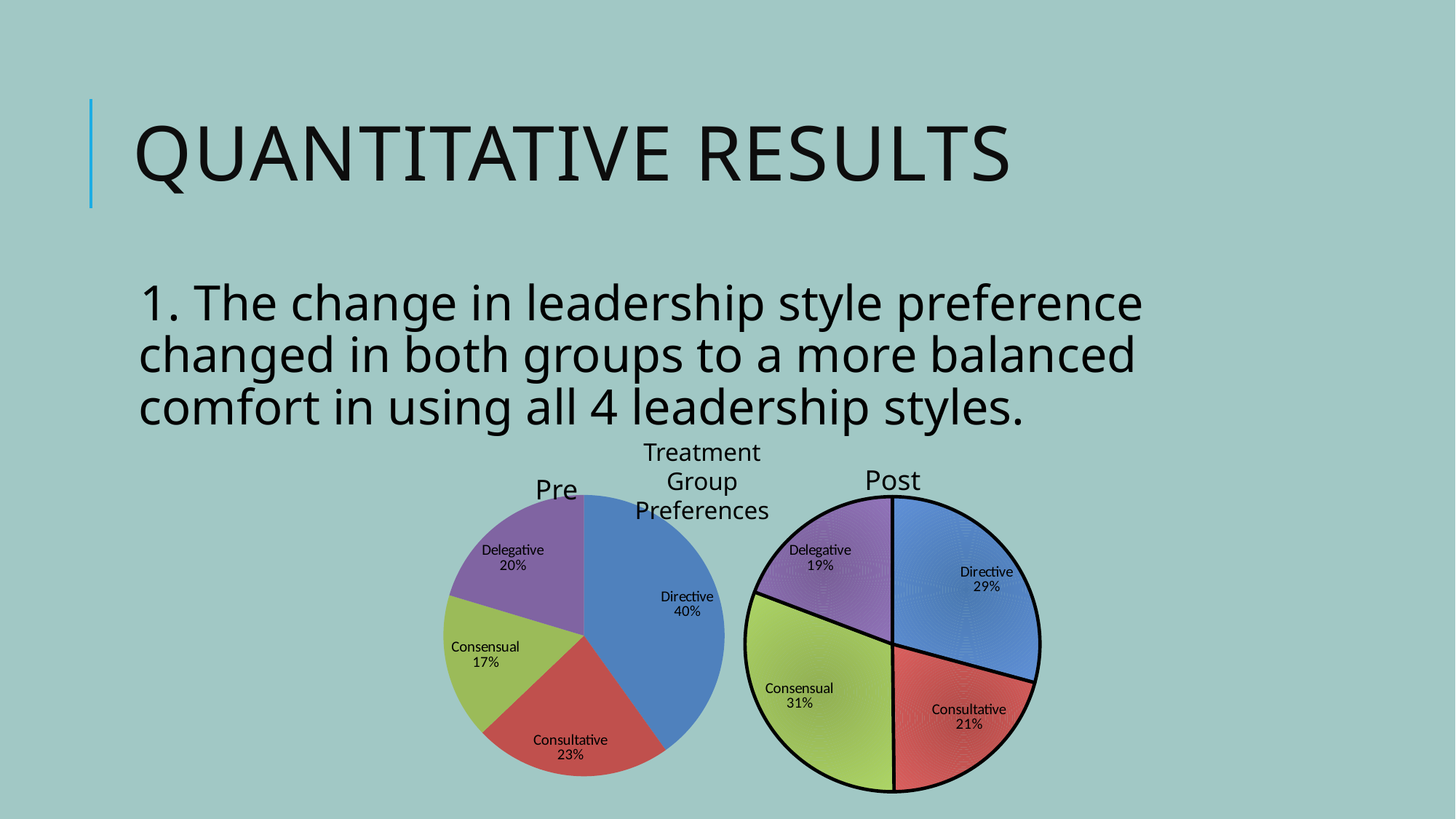
In the Post pie chart, what share does Consensual have? 31% In the Pre pie chart, which leadership style has the smallest share? Consensual How many slices does the Post pie chart have? 4 What is the title shown between the two pie charts? Treatment Group Preferences In the Pre pie chart, which is larger, Consultative or Delegative? Consultative In the Pre pie chart, which leadership style has the largest share? Directive In the Post pie chart, which leadership style has the largest share? Consensual In the Post pie chart, what is the difference between the Consensual and Consultative shares? 10% In the Pre pie chart, what share does Directive have? 40% In the Post pie chart, which leadership style has the smallest share? Delegative What is the difference between the Directive share in the Pre chart and the Directive share in the Post chart? 11% What type of chart is used to show the Pre and Post preferences? Pie chart